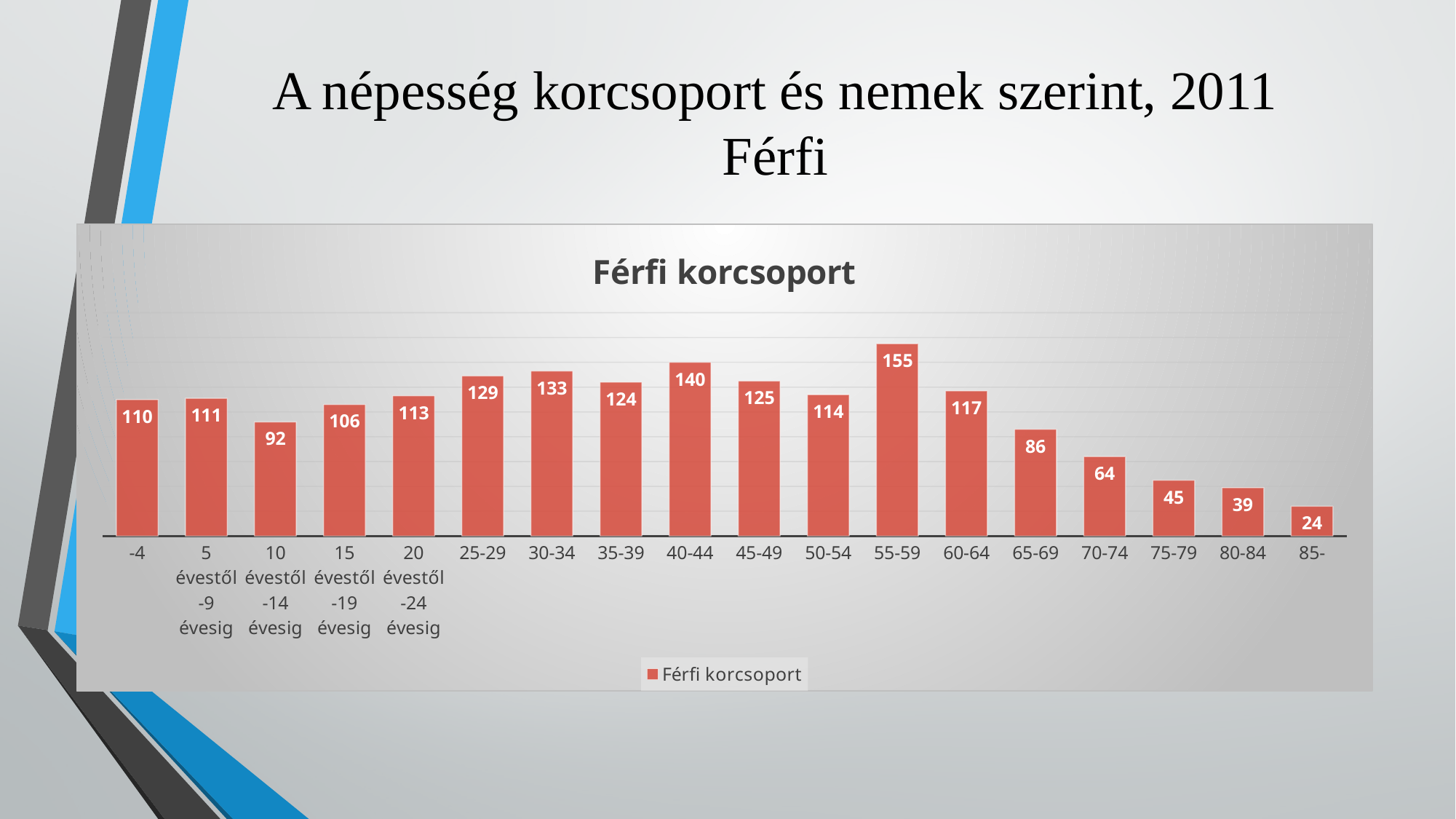
What is the title of the chart? Férfi korcsoport What is the difference between the values for 55-59 and 60-64? 38 How many series does the legend list? 1 Which is larger, the value for 30-34 or the value for 35-39? 30-34 What is the value for the 85- age group? 24 What is the value for the 40-44 age group? 140 What kind of chart is shown on the slide? bar chart Which age group has the lowest value? 85- Which age group has the highest value? 55-59 What is the value for the 55-59 age group? 155 How many age groups are shown on the chart? 18 Do the values rise or fall from the 60-64 age group to the 85- age group? fall